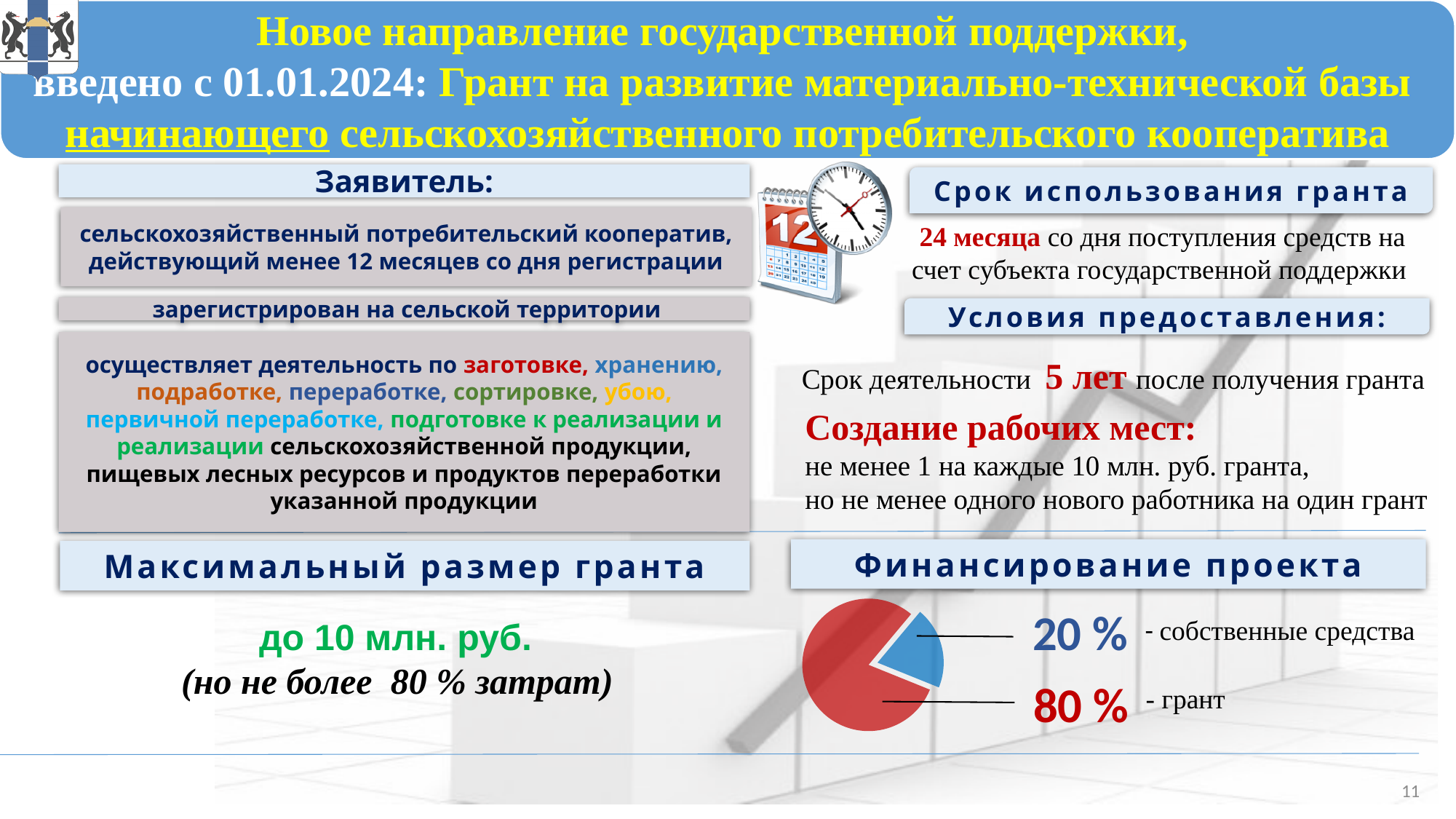
In the pie chart under "Финансирование проекта", what share is labelled "грант"? 80 % In the pie chart under "Финансирование проекта", what is the difference in percentage points between the "грант" share and the "собственные средства" share? 60 % In the pie chart under "Финансирование проекта", what share is labelled "собственные средства"? 20 % In the pie chart under "Финансирование проекта", what colour is the "грант" slice? red How many slices does the pie chart under "Финансирование проекта" have? 2 In the pie chart under "Финансирование проекта", which slice is the smallest? собственные средства In the pie chart under "Финансирование проекта", what colour is the "собственные средства" slice? blue In the pie chart under "Финансирование проекта", which slice is the largest? грант In the pie chart under "Финансирование проекта", which is larger: the share for "грант" or the share for "собственные средства"? грант In the pie chart under "Финансирование проекта", is the share for "собственные средства" greater or less than 50 %? less What kind of chart is shown under the heading "Финансирование проекта"? pie chart